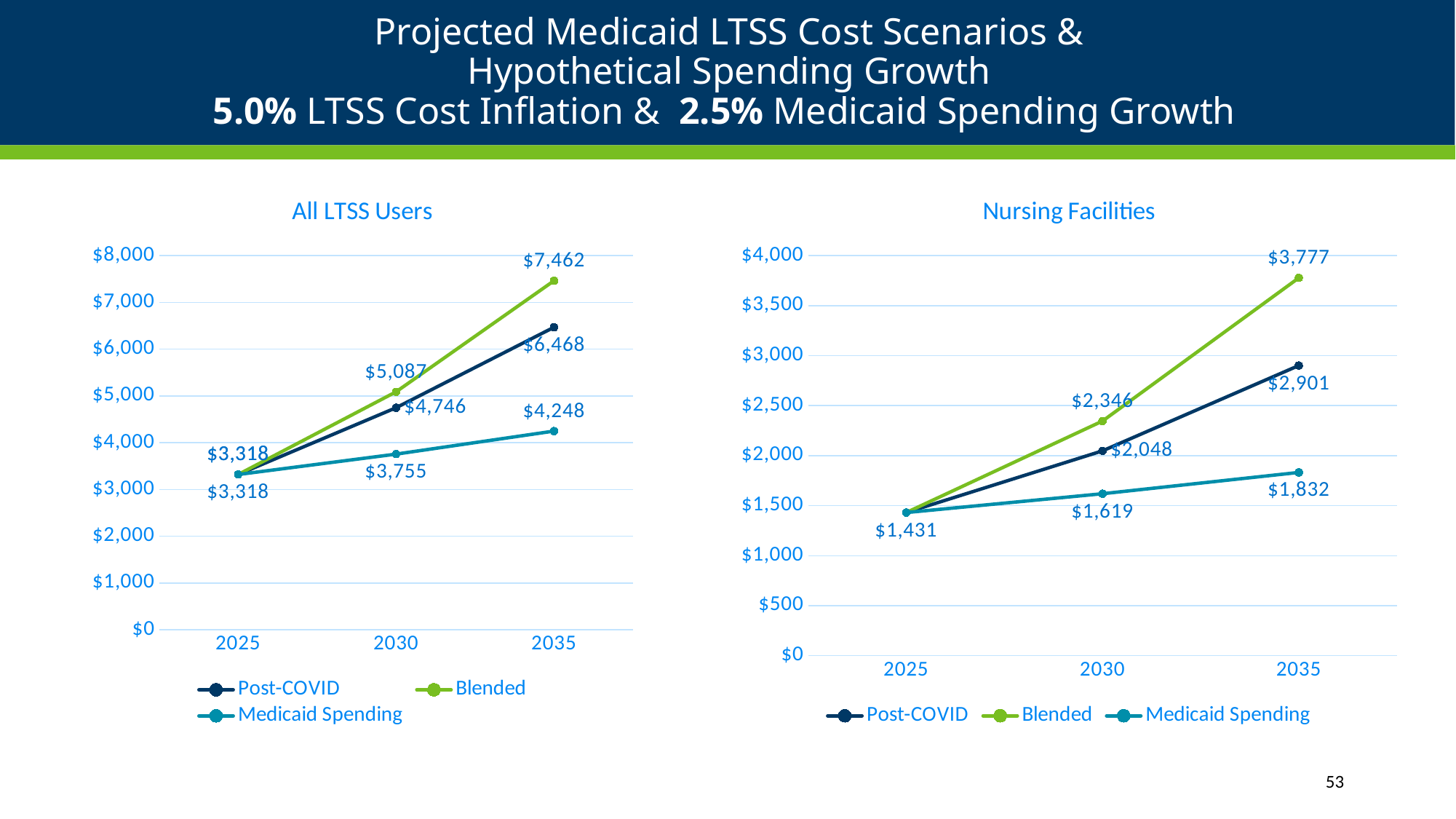
In the All LTSS Users chart, which is larger in 2030: the Post-COVID value or the Medicaid Spending value? Post-COVID In the All LTSS Users chart, which series has the highest value in 2035? Blended What kind of chart is the All LTSS Users chart? Line chart In the Nursing Facilities chart, which series has the lowest value in 2035? Medicaid Spending In the All LTSS Users chart, what is the difference between the Blended and Post-COVID values in 2035? $994 In the All LTSS Users chart, what is the Blended value in 2035? $7,462 In the Nursing Facilities chart, what is the Post-COVID value in 2035? $2,901 In the All LTSS Users chart, what is the Medicaid Spending value in 2030? $3,755 In the Nursing Facilities chart, what is the difference between the Blended and Medicaid Spending values in 2030? $727 In the Nursing Facilities chart, does the Blended series rise or fall from 2025 to 2035? Rise In the Nursing Facilities chart, what is the value shared by all three series in 2025? $1,431 How many series does the legend of the Nursing Facilities chart list? 3